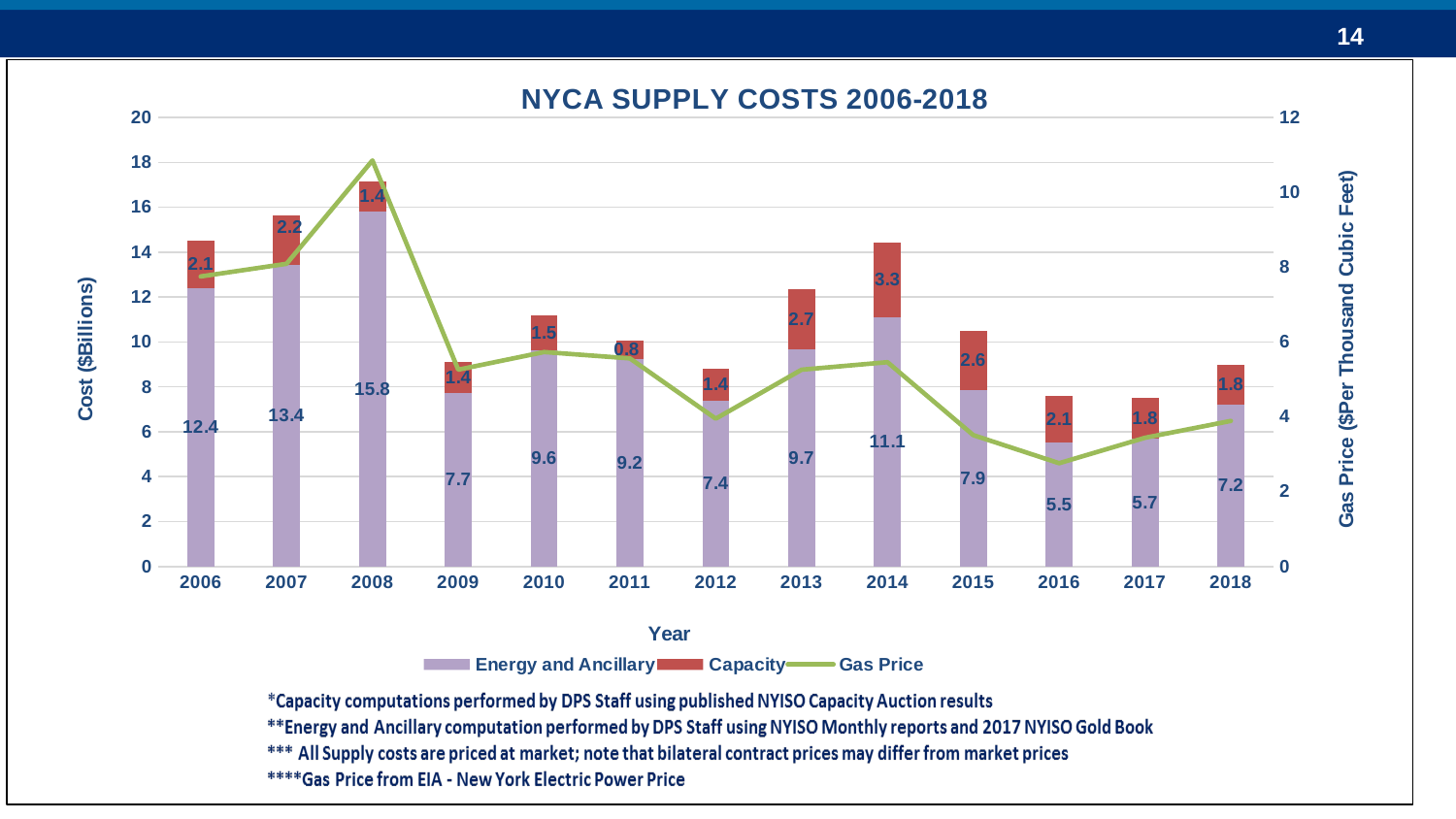
Is the Gas Price for 2008 greater or less than 10 on the right axis? greater Which year has the lowest Capacity cost? 2011 Which year has the highest Energy and Ancillary cost? 2008 What is the Capacity cost for 2014? 3.3 What is the Energy and Ancillary cost for 2008? 15.8 What kind of chart is this? Stacked bar chart with a line Which is larger, the Capacity cost in 2013 or in 2015? 2013 What is the label of the right-hand vertical axis? Gas Price ($Per Thousand Cubic Feet) What is the total supply cost (Energy and Ancillary plus Capacity) for 2014? 14.4 What is the difference between the Energy and Ancillary cost in 2006 and in 2009? 4.7 How many years are shown on the x axis? 13 How many series does the legend list? 3